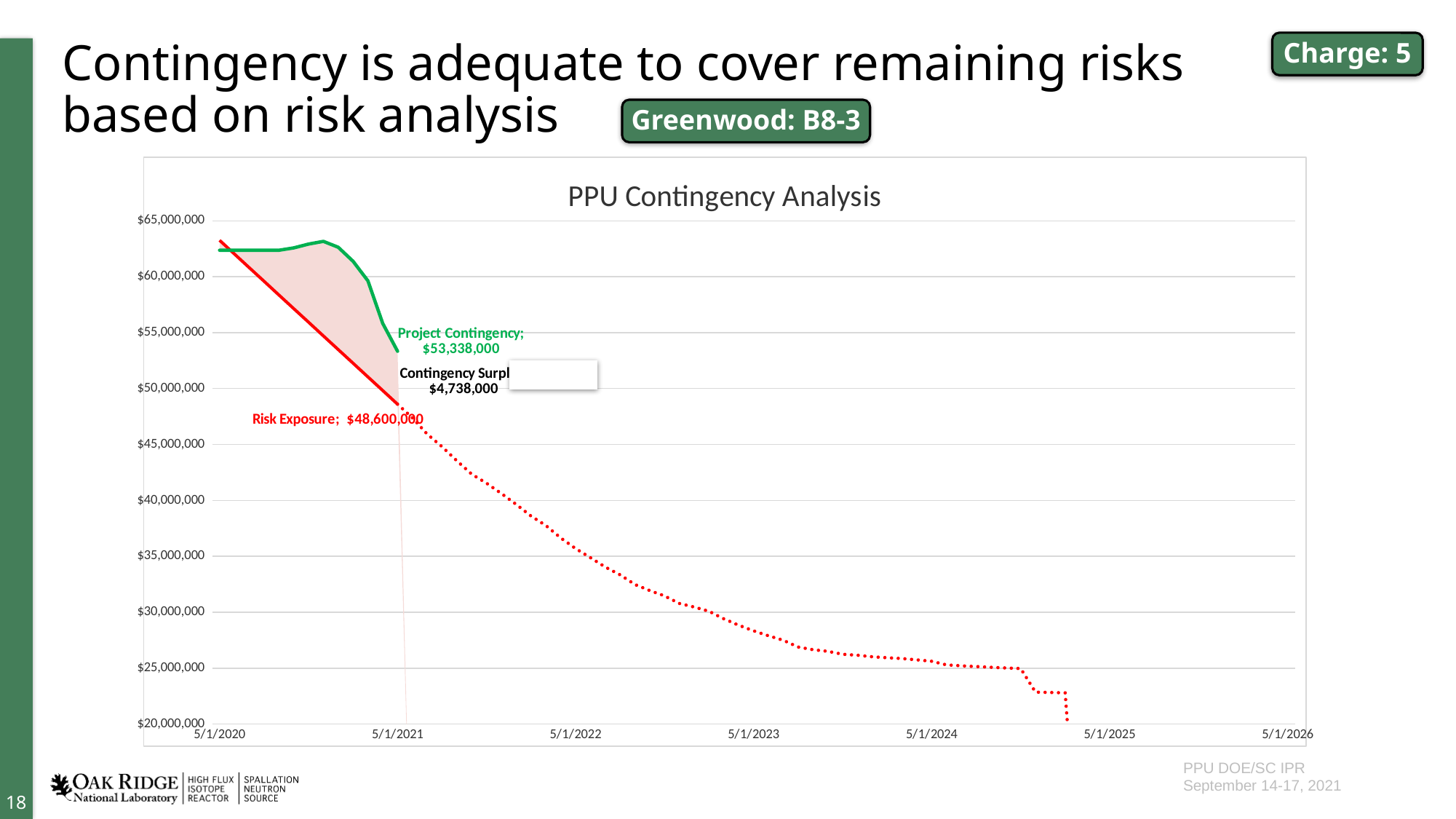
What is the labelled value of Project Contingency on the PPU Contingency Analysis chart? $53,338,000 At the labelled point, which is larger: Project Contingency or Risk Exposure? Project Contingency What is the difference between the labelled Project Contingency and the labelled Risk Exposure? $4,738,000 What is the labelled value of Risk Exposure on the chart? $48,600,000 What is the last date shown on the x axis of the chart? 5/1/2026 Is the Risk Exposure value at 5/1/2020 greater or less than $60,000,000? greater What is the labelled Contingency Surplus on the chart? $4,738,000 What colour is the Project Contingency line? Green What kind of chart is the PPU Contingency Analysis? Line chart Is the lowest point of the Risk Exposure line greater or less than $25,000,000? less What is the title of the chart? PPU Contingency Analysis Does the Risk Exposure line rise or fall as time moves along the x axis? Fall